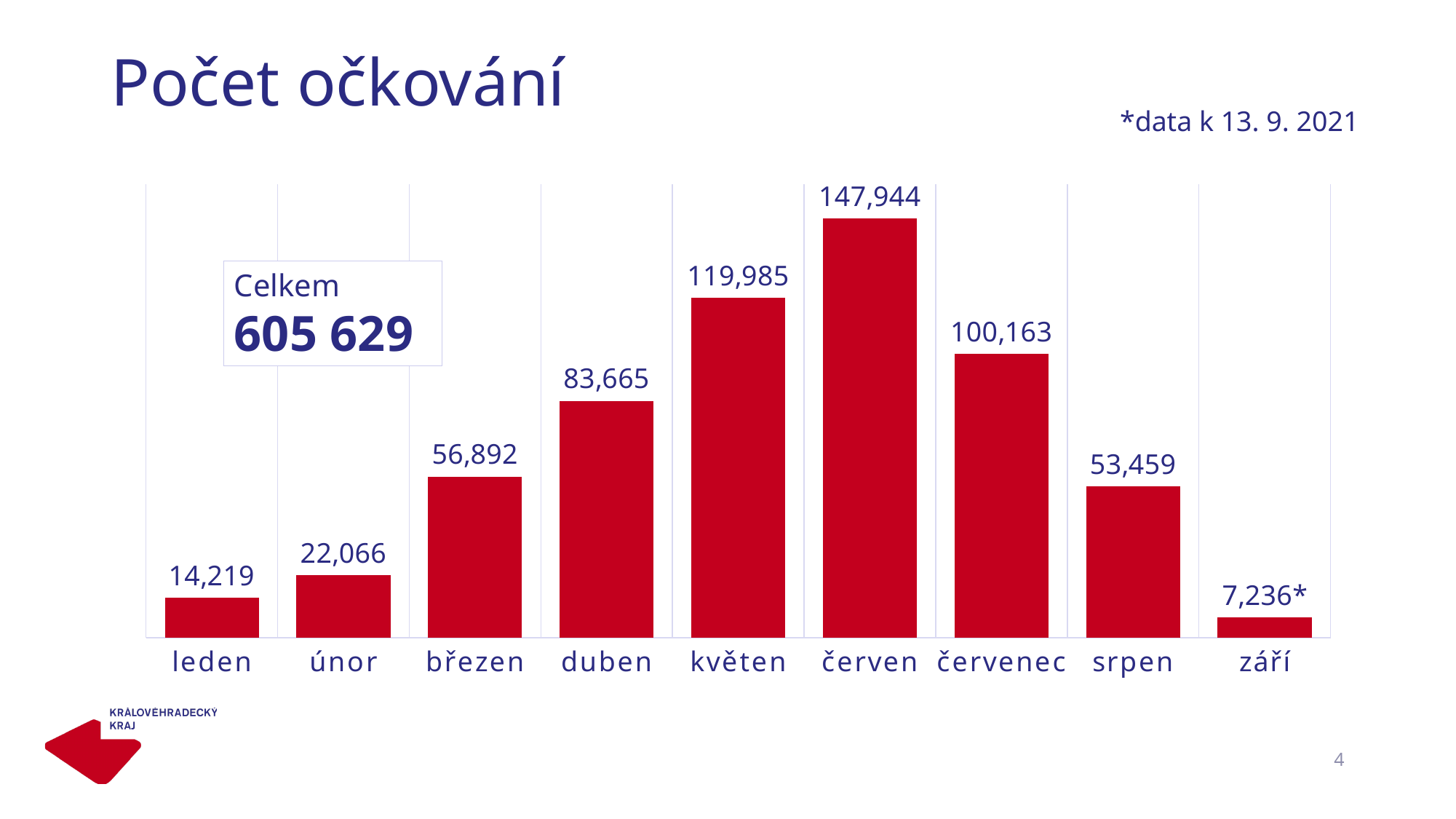
How many months are shown on the x axis? 9 Which month has the highest value? červen What kind of chart is shown on the slide? bar chart What is the value for srpen? 53,459 Which is larger, the value for duben or the value for březen? duben What is the value for leden? 14,219 What total (Celkem) is shown in the box on the chart? 605 629 What is the value for květen? 119,985 Do the values rise or fall from leden to červen? rise What is the difference between the values for červenec and srpen? 46,704 What is the difference between the values for červen and květen? 27,959 Which month has the lowest value? září